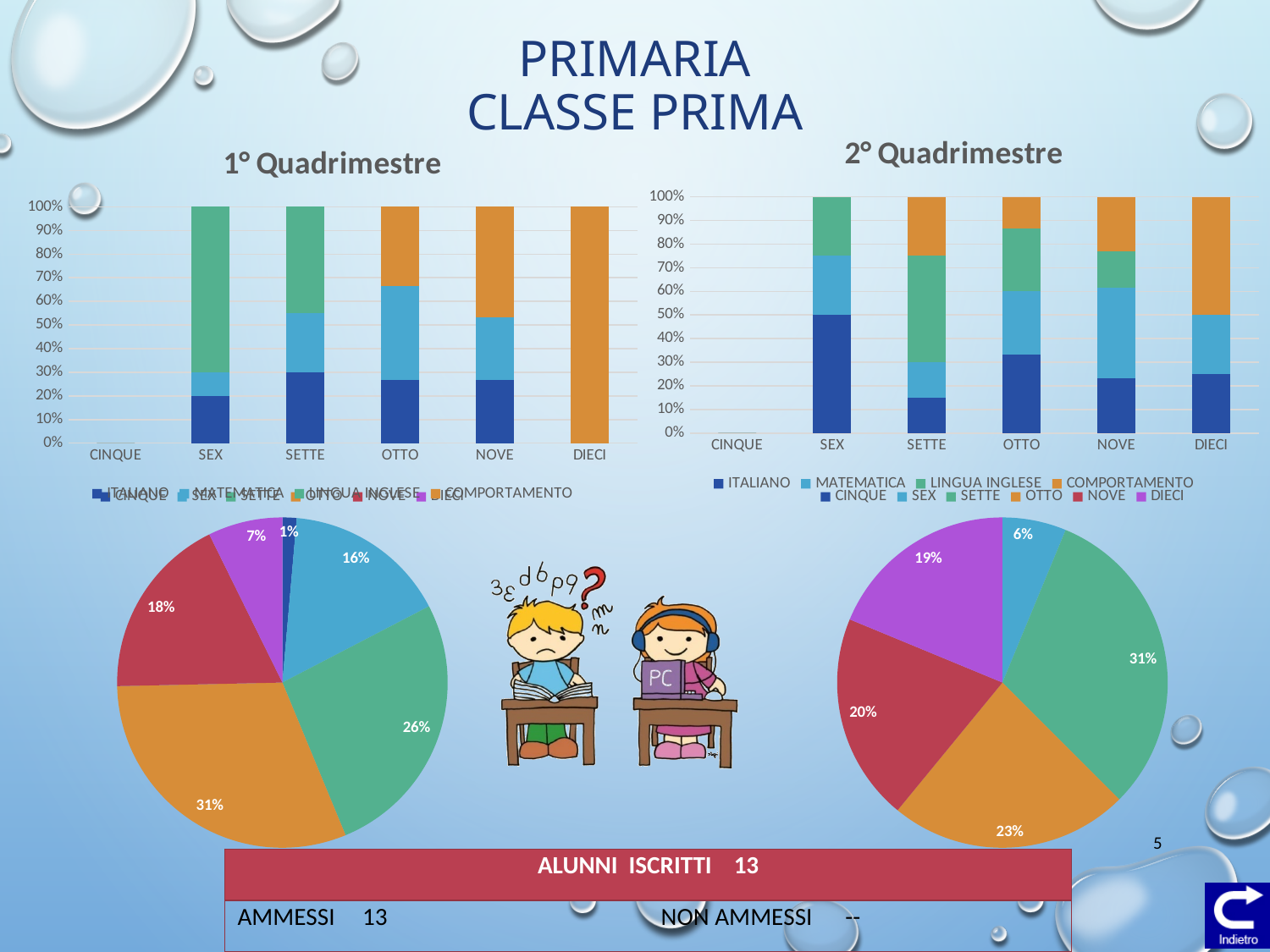
In the right pie chart, which category has the largest share? SETTE In the 1° Quadrimestre chart, is the ITALIANO value for SETTE greater or less than 20%? greater In the left pie chart, which category has the smallest share? CINQUE In the right pie chart, what share does NOVE have? 20% In the left pie chart, what is the difference between the shares of SETTE and SEX? 10% In the 2° Quadrimestre chart, is the ITALIANO value for SEX greater or less than 40%? greater In the 2° Quadrimestre chart, which colour represents COMPORTAMENTO? Orange How many categories are shown on the x axis of the 1° Quadrimestre chart? 6 What kind of chart is the 1° Quadrimestre chart? Stacked bar chart How many series does the legend of the 2° Quadrimestre chart list? 4 In the right pie chart, which is larger, the share of OTTO or the share of DIECI? OTTO In the left pie chart, what share does OTTO have? 31%